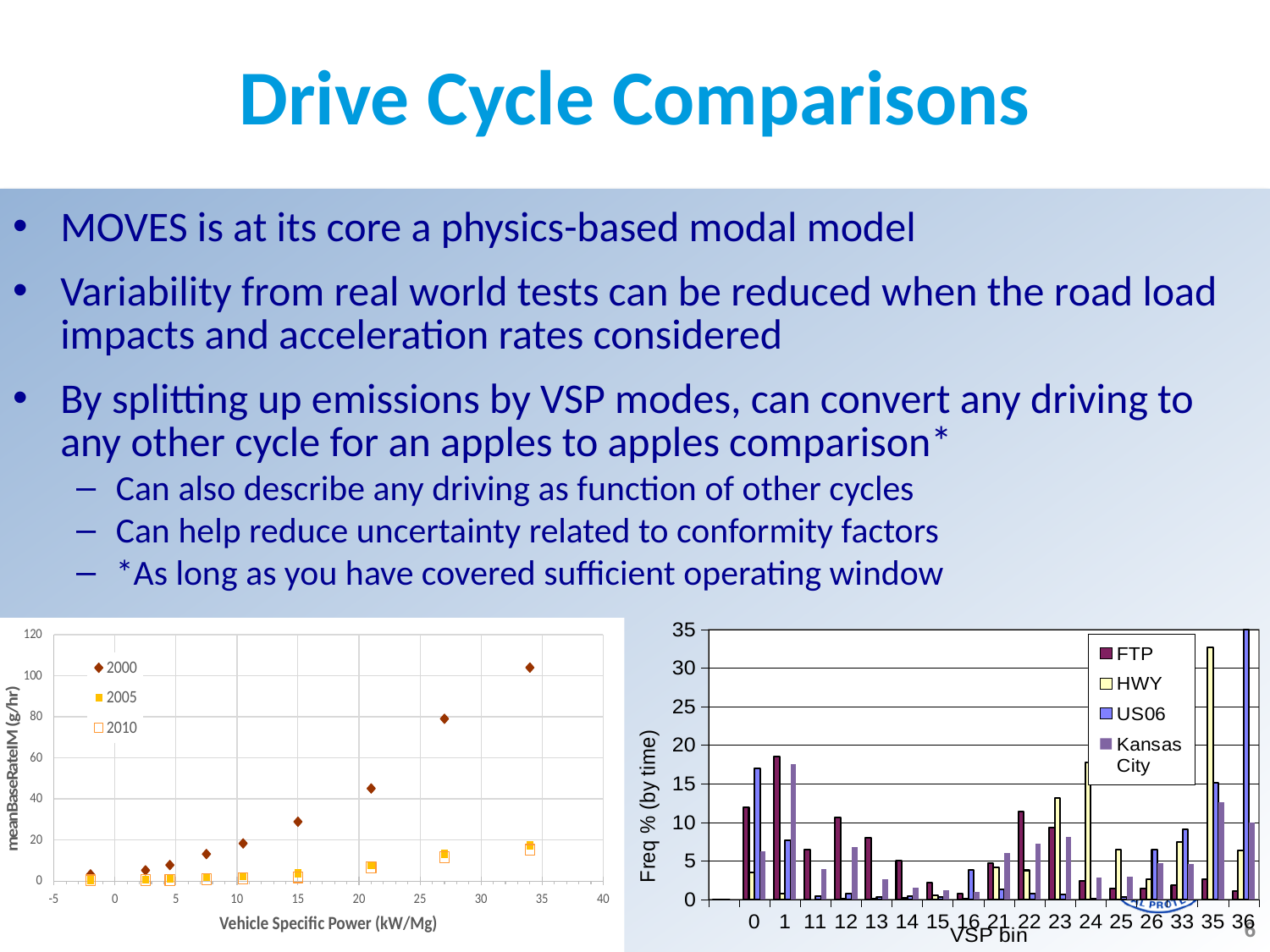
In the left-hand scatter chart, how many series does the legend list? 3 In the right-hand bar chart, is the HWY value for VSP bin 35 greater or less than 30? greater In the right-hand bar chart, at VSP bin 0, which is larger: FTP or US06? US06 In the right-hand bar chart, is the FTP value for VSP bin 1 greater or less than 15? greater In the right-hand bar chart, how many VSP bins are shown on the x axis? 17 In the right-hand bar chart, how many series does the legend list? 4 What kind of chart is the chart on the left of the slide (meanBaseRateIM vs Vehicle Specific Power)? scatter chart In the right-hand bar chart, which VSP bin has the highest FTP value? 1 In the left-hand scatter chart, do the 2000 series values rise or fall as Vehicle Specific Power increases? rise What kind of chart is the chart on the right of the slide (Freq % by VSP bin)? bar chart In the right-hand bar chart, which VSP bin has the highest HWY value? 35 What is the x-axis title of the left-hand scatter chart? Vehicle Specific Power (kW/Mg)